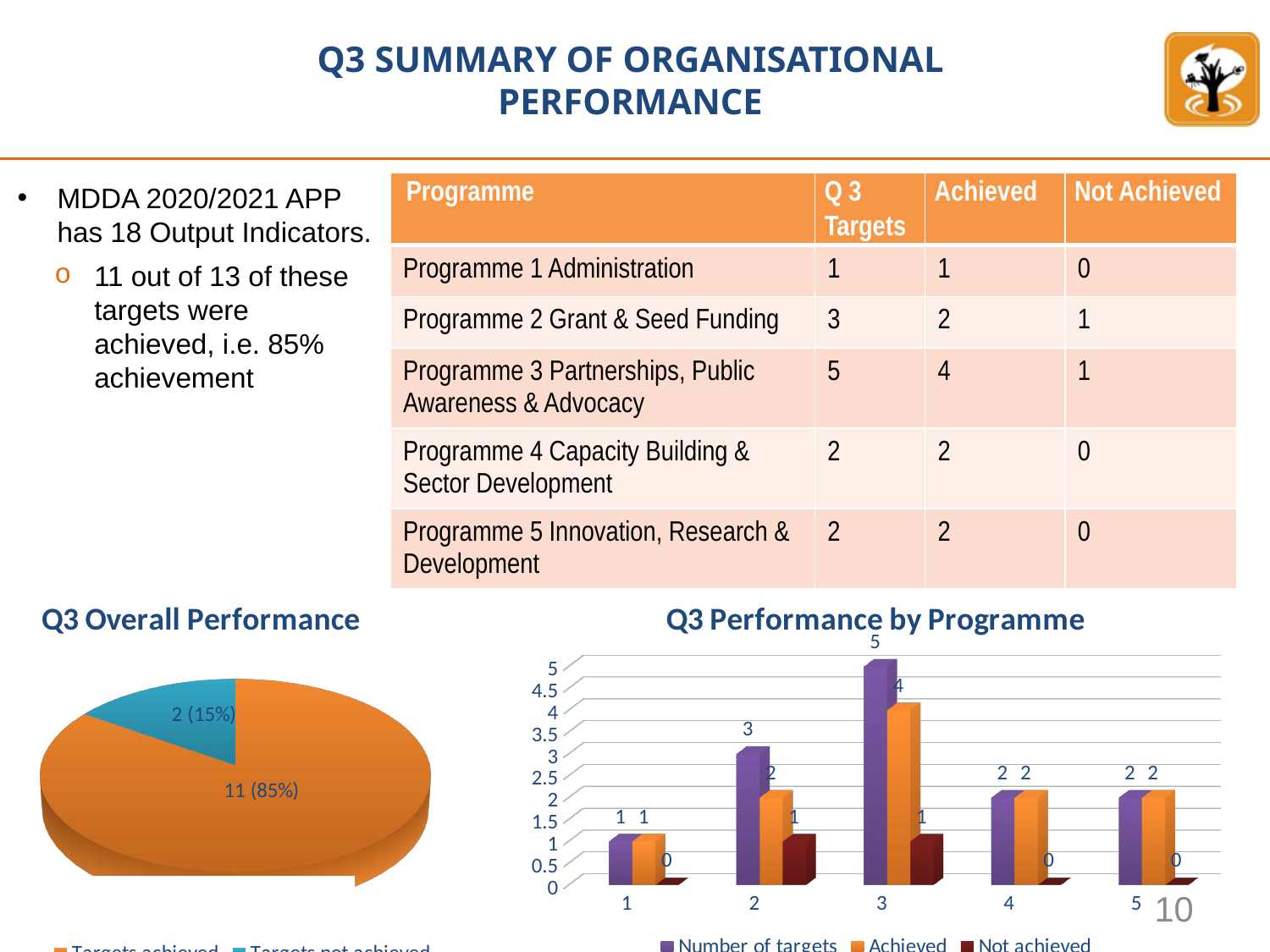
What kind of chart is 'Q3 Performance by Programme'? Bar chart How many programmes are shown on the x axis of the 'Q3 Performance by Programme' chart? 5 In the 'Q3 Performance by Programme' chart, what is the difference between Number of targets and Achieved for programme 3? 1 In the 'Q3 Performance by Programme' chart, what is the Number of targets for programme 3? 5 In the 'Q3 Performance by Programme' chart, what is the Not achieved value for programme 4? 0 In the 'Q3 Performance by Programme' chart, is the Number of targets larger for programme 2 or programme 4? Programme 2 In the 'Q3 Overall Performance' pie chart, what is the value for targets not achieved? 2 (15%) In the 'Q3 Performance by Programme' chart, which programme has the lowest Achieved value? 1 In the 'Q3 Performance by Programme' chart, what is the Achieved value for programme 2? 2 In the 'Q3 Overall Performance' pie chart, what share of targets were achieved? 85% How many series does the legend of the 'Q3 Performance by Programme' chart list? 3 In the 'Q3 Performance by Programme' chart, which programme has the highest Number of targets? 3